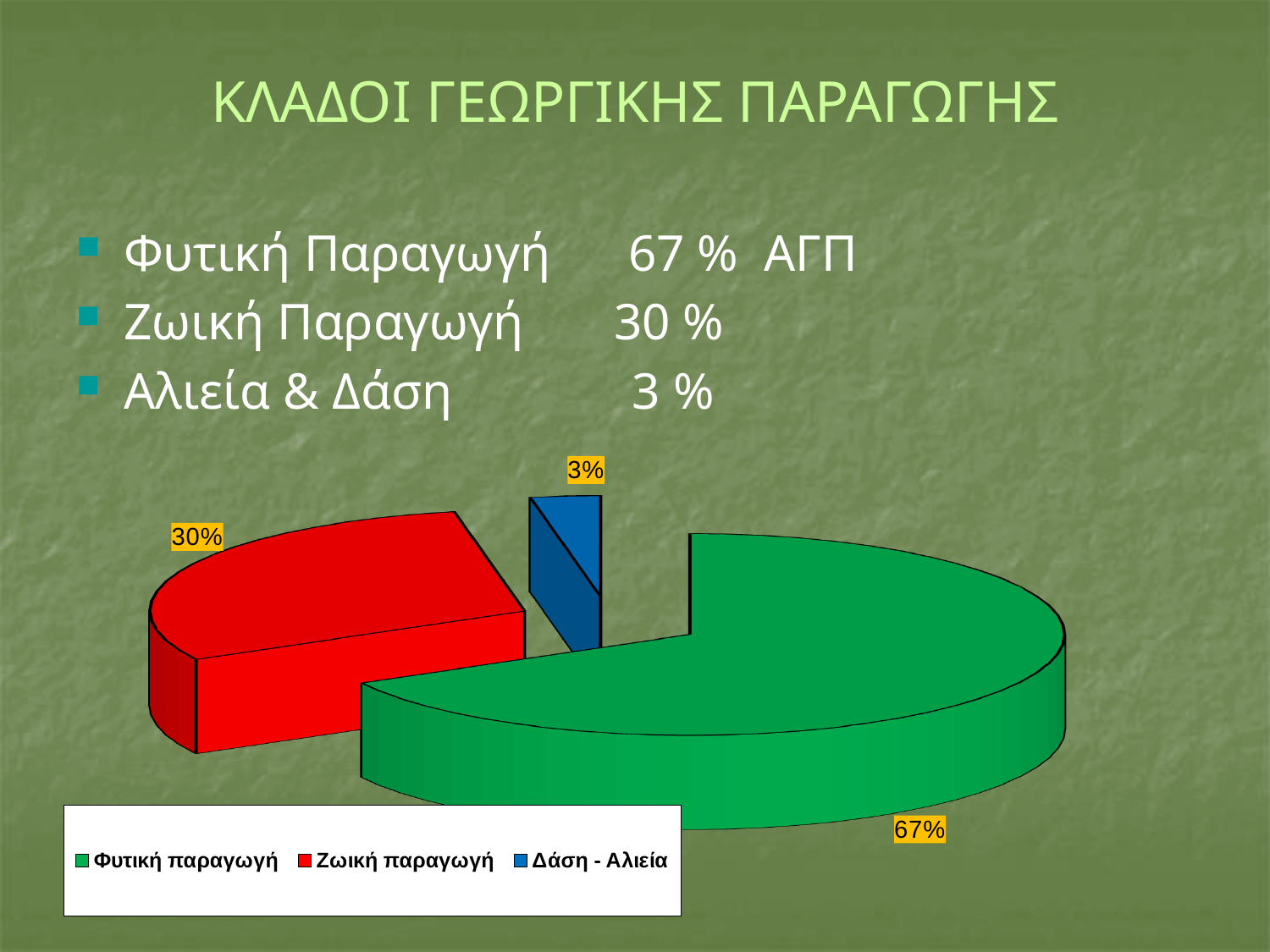
What kind of chart is shown on the slide? pie chart Which is larger, the slice for Ζωική παραγωγή or the slice for Δάση - Αλιεία? Ζωική παραγωγή Which slice of the pie is the smallest? Δάση - Αλιεία What is the difference in percentage points between Ζωική παραγωγή and Δάση - Αλιεία? 27 What share of the pie does Ζωική παραγωγή have? 30% Which slice of the pie is the largest? Φυτική παραγωγή What colour is the slice for Ζωική παραγωγή? red What share of the pie does Δάση - Αλιεία have? 3% How many entries does the legend list? 3 What share of the pie does Φυτική παραγωγή have? 67% How many slices does the pie chart have? 3 What is the difference in percentage points between Φυτική παραγωγή and Ζωική παραγωγή? 37